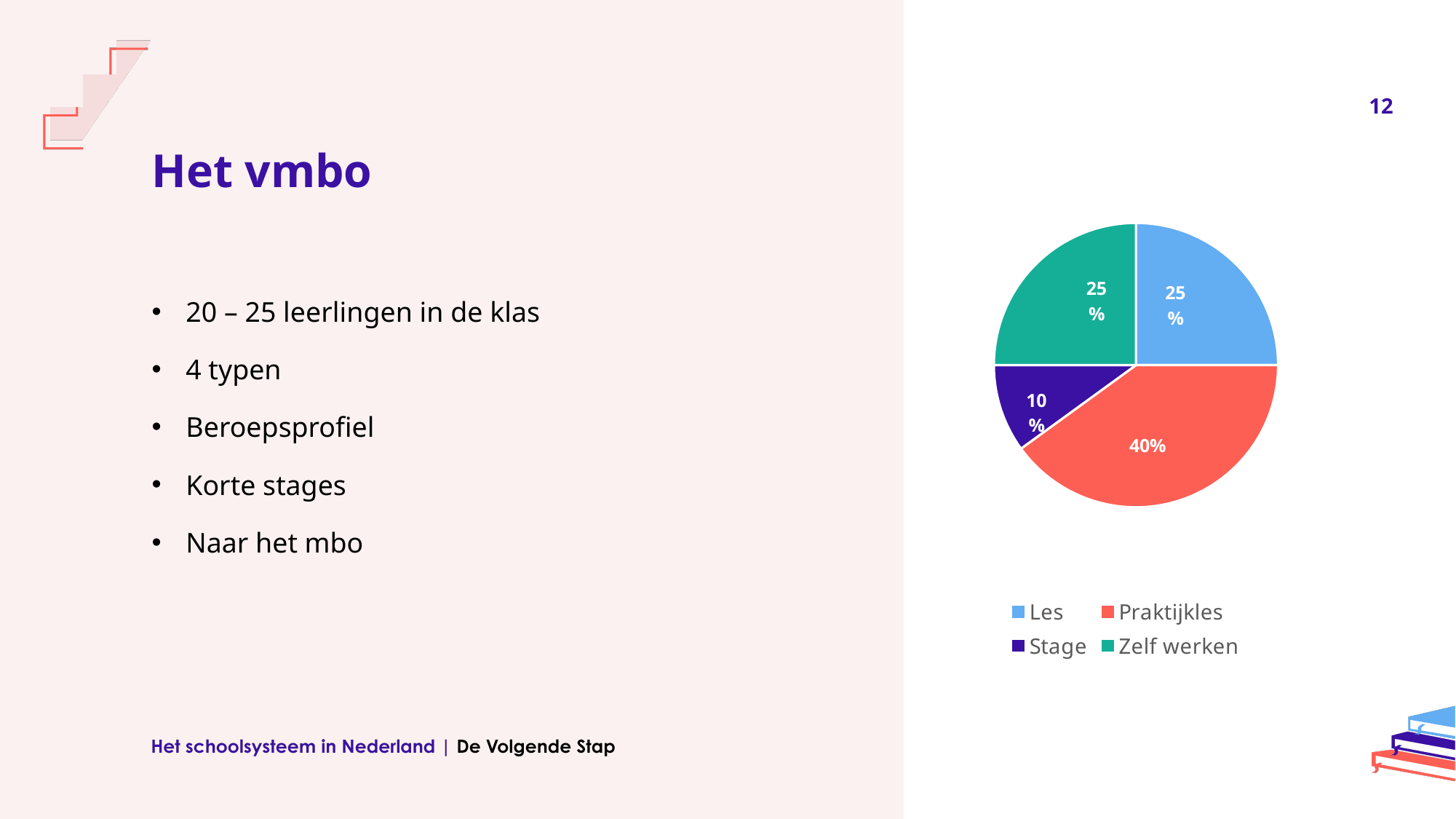
What kind of chart is shown on the slide? pie chart Which category has the largest slice of the pie chart? Praktijkles What percentage of the pie chart is Zelf werken? 25% Which category has the smallest slice of the pie chart? Stage What percentage of the pie chart is Praktijkles? 40% What percentage of the pie chart is Les? 25% How many slices does the pie chart have? 4 Which is larger in the pie chart, Praktijkles or Les? Praktijkles What is the difference in percentage points between Praktijkles and Stage? 30 What colour is the Zelf werken slice in the pie chart? green What percentage of the pie chart is Stage? 10% How many entries does the legend of the pie chart list? 4